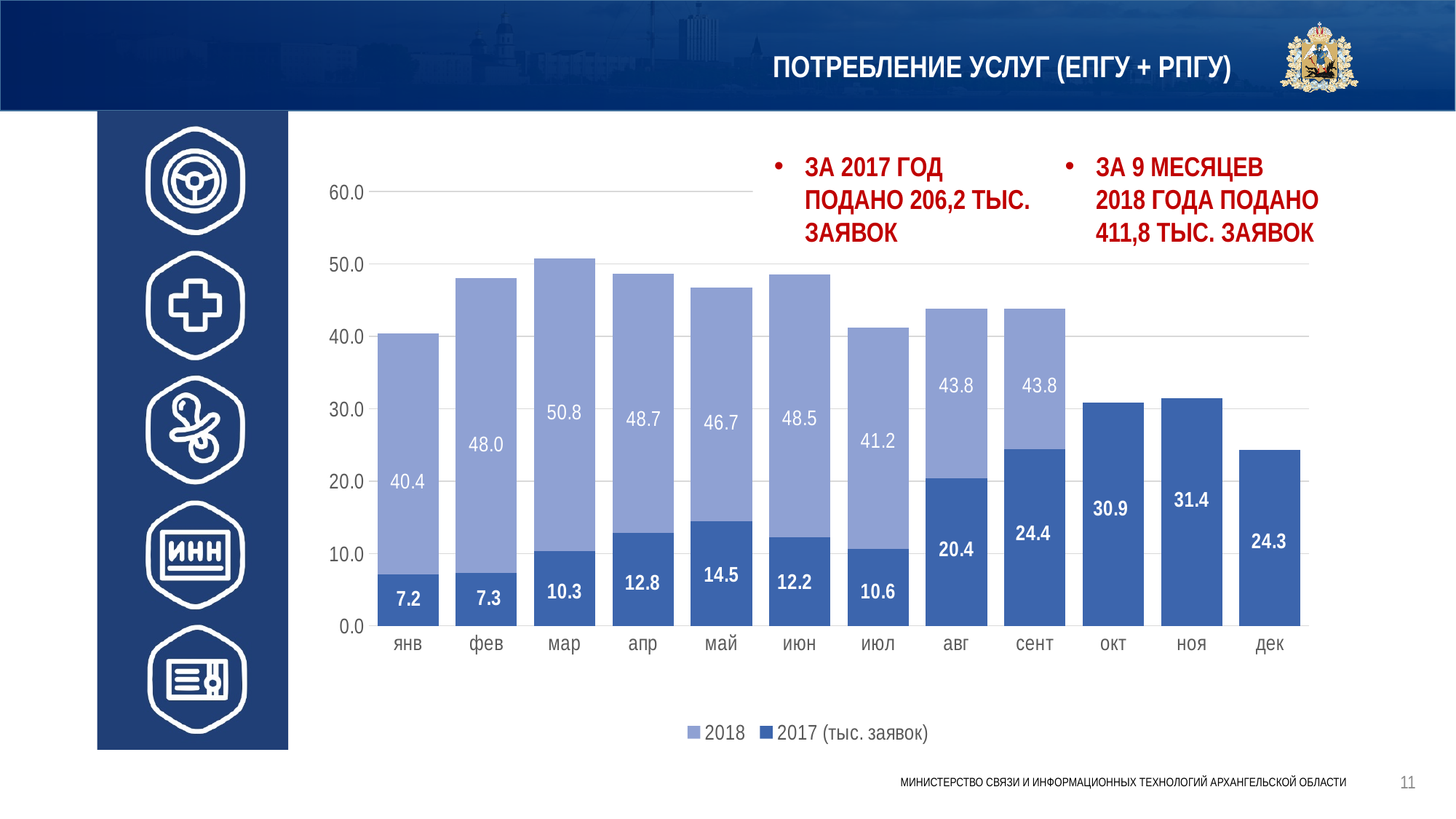
Which month has the highest 2018 value? мар Do the 2017 values rise or fall from янв to май? rise How many series does the legend list? 2 Is the 2018 value for июл greater or less than 40.0? greater How many months are shown on the x axis? 12 What kind of chart is shown on the slide? bar chart What is the 2017 value for янв? 7.2 What is the difference between the 2018 and 2017 values for сент? 19.4 Which is larger, the 2017 value for окт or the 2017 value for дек? окт Which month has the lowest 2017 value? янв What is the 2018 value for мар? 50.8 What is the 2017 value for ноя? 31.4